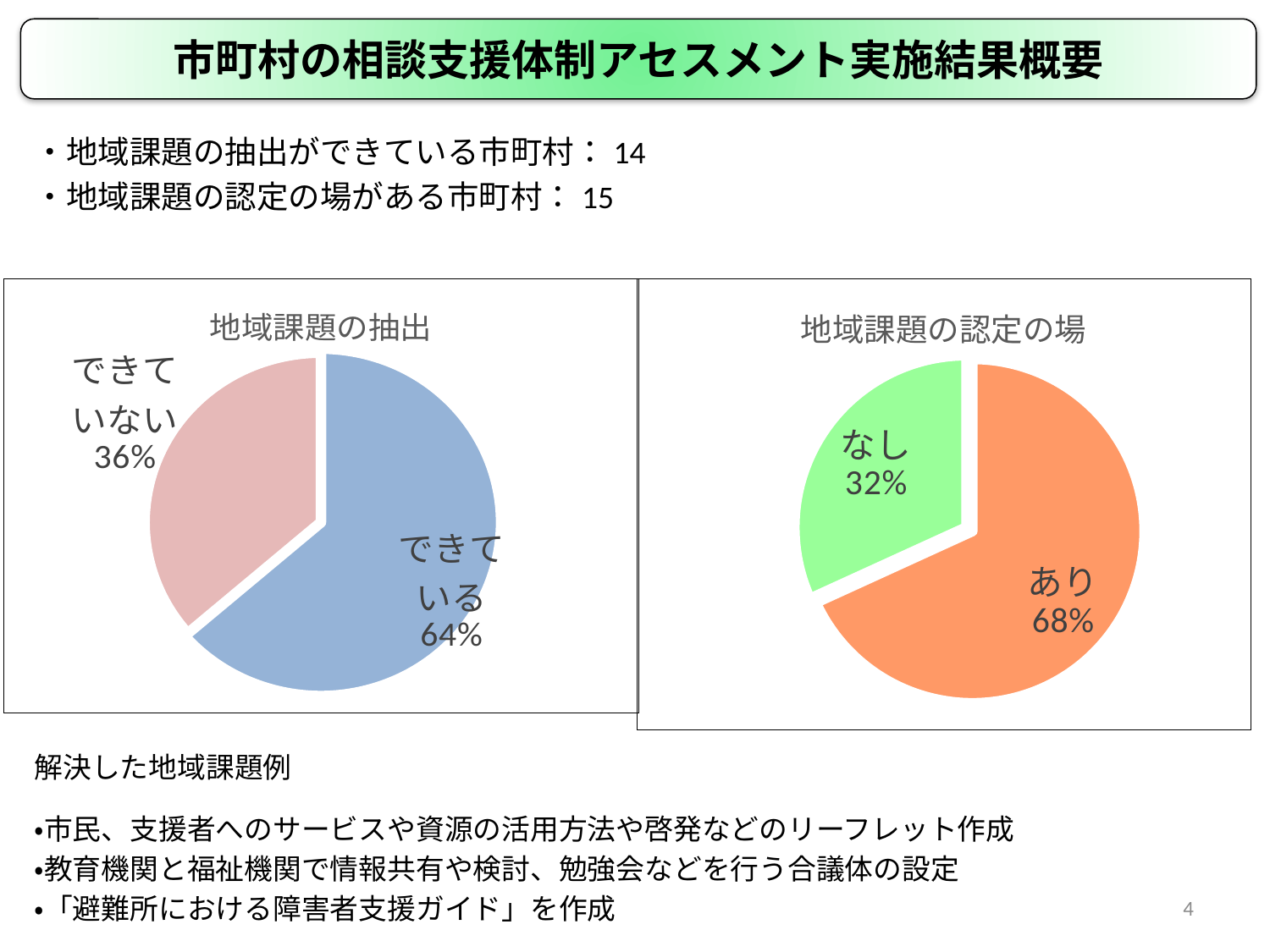
How many slices does the chart titled 地域課題の認定の場 have? 2 In the chart titled 地域課題の抽出, what is the difference in percentage points between できている and できていない? 28 In the chart titled 地域課題の認定の場, which slice is the smallest? なし What kind of chart is the chart titled 地域課題の抽出? pie chart In the chart titled 地域課題の抽出, which slice is the largest? できている In the chart titled 地域課題の抽出, what share does できていない have? 36% In the chart titled 地域課題の認定の場, what share does あり have? 68% In the chart titled 地域課題の認定の場, which is larger, あり or なし? あり What is the title of the chart on the right side of the slide? 地域課題の認定の場 In the chart titled 地域課題の認定の場, what is the difference in percentage points between あり and なし? 36 In the chart titled 地域課題の認定の場, what share does なし have? 32% In the chart titled 地域課題の抽出, what share does できている have? 64%